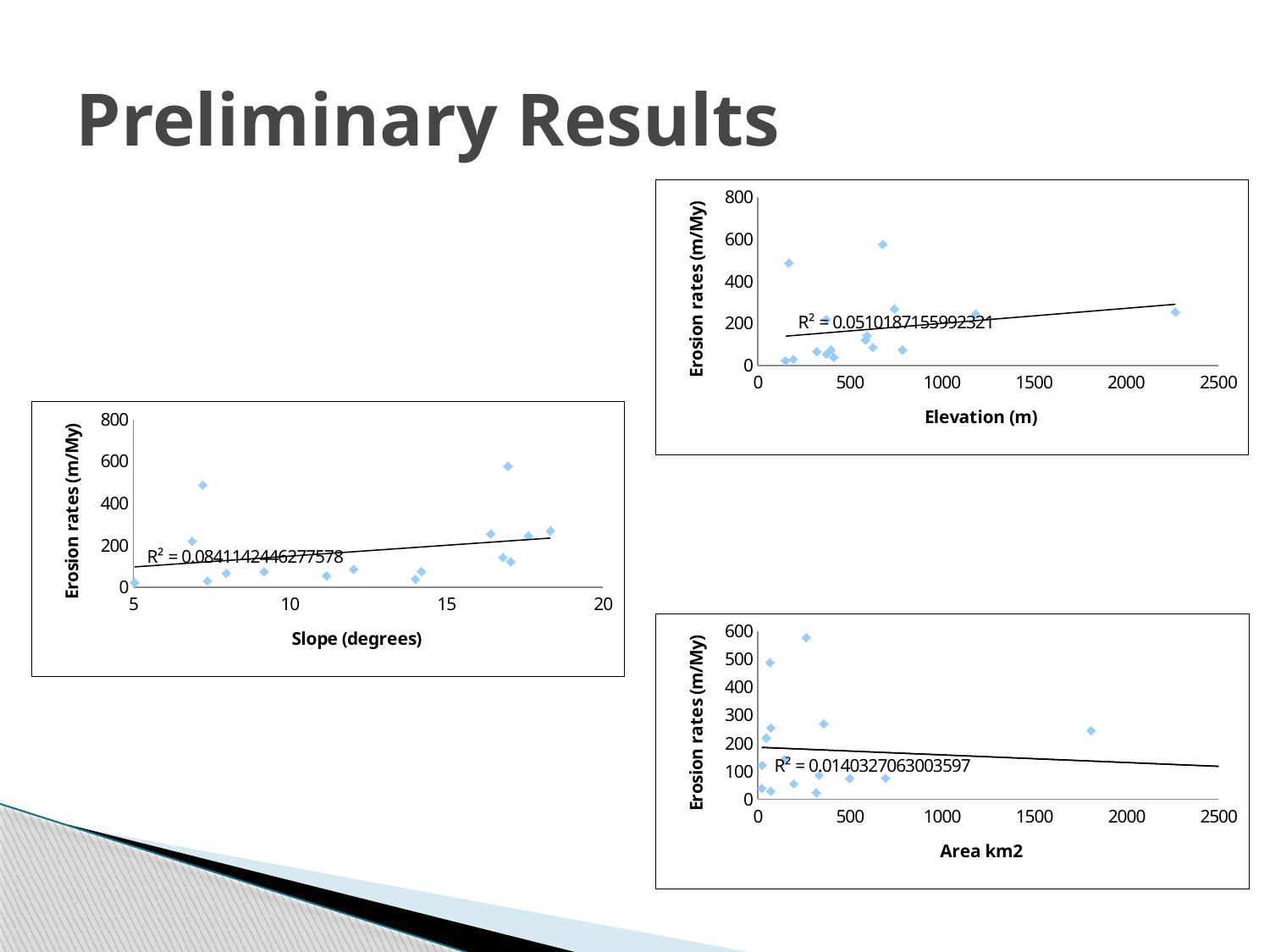
In the chart with x-axis 'Slope (degrees)', is the erosion rate of the highest point greater or less than 400? greater In the chart with x-axis 'Area km2', does the trendline rise or fall as area increases? fall Which of the three charts has the highest printed R² value? the Slope (degrees) chart What is the y-axis label shared by all three charts? Erosion rates (m/My) In the chart with x-axis 'Elevation (m)', what R² value is printed? R² = 0.0510187155992321 In the chart with x-axis 'Area km2', what R² value is printed? R² = 0.0140327063003597 In the chart with x-axis 'Elevation (m)', does the trendline rise or fall as elevation increases? rise In the chart with x-axis 'Area km2', is the erosion rate of the point near 1800 km2 greater or less than 200? greater Which of the three charts has the lowest printed R² value? the Area km2 chart What kind of chart is the chart with x-axis 'Slope (degrees)'? scatter chart In the chart with x-axis 'Slope (degrees)', what R² value is printed? R² = 0.0841142446277578 How many charts are shown on the slide? 3